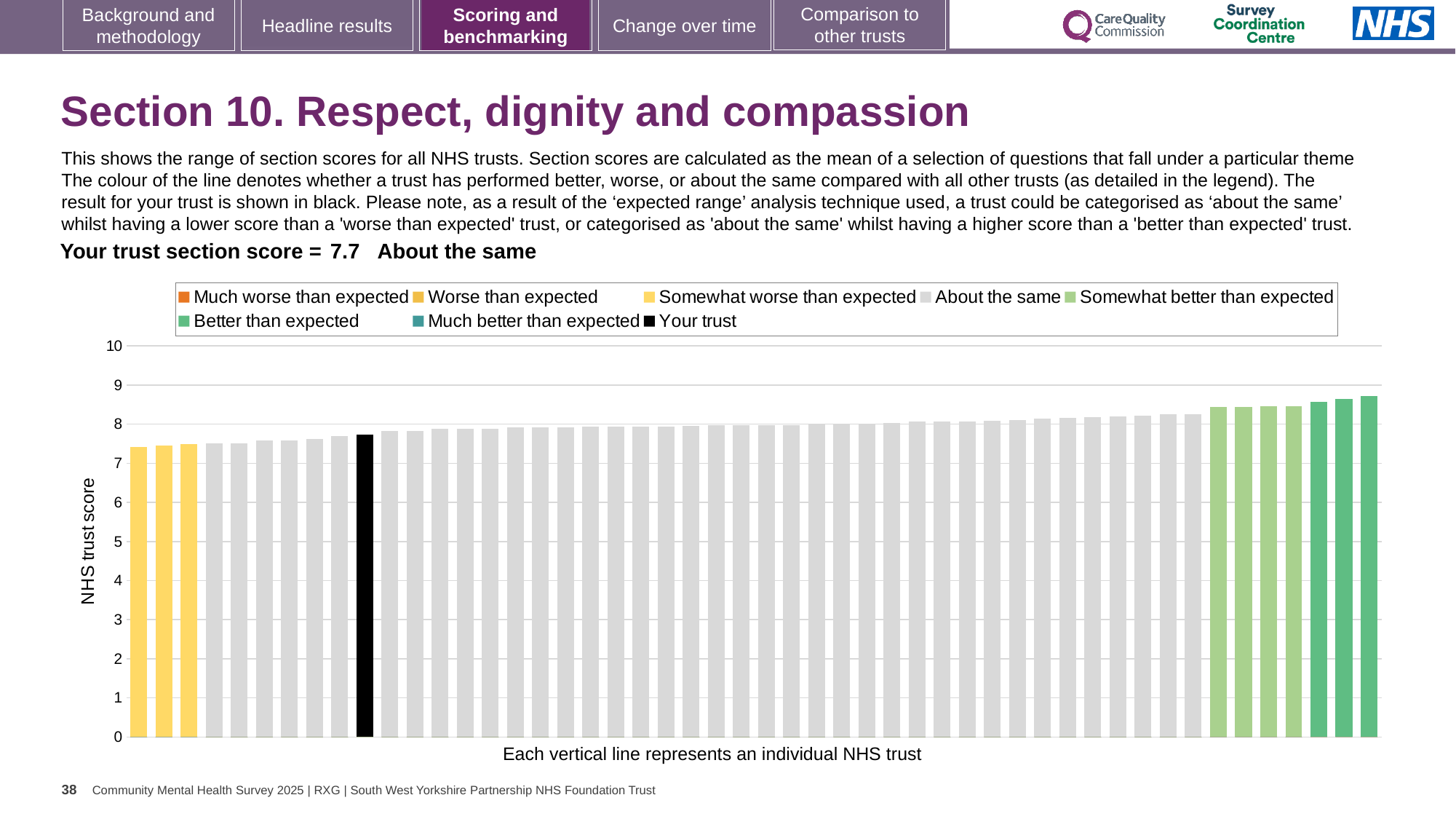
Is the value of the black 'Your trust' bar greater or less than 7? greater How many bars are coloured yellow ('Somewhat worse than expected')? 3 Is the value of the black 'Your trust' bar greater or less than 8? less Is the value of the rightmost (highest) bar greater or less than 8? greater How many entries does the chart legend list? 8 What is the section score for your trust shown on the slide? 7.7 What is the label on the vertical axis of the chart? NHS trust score What kind of chart is shown on the slide? bar chart Do the bar values rise or fall from left to right along the x axis? rise How many bars are coloured light green ('Somewhat better than expected')? 4 Which category is your trust placed in according to the slide? About the same